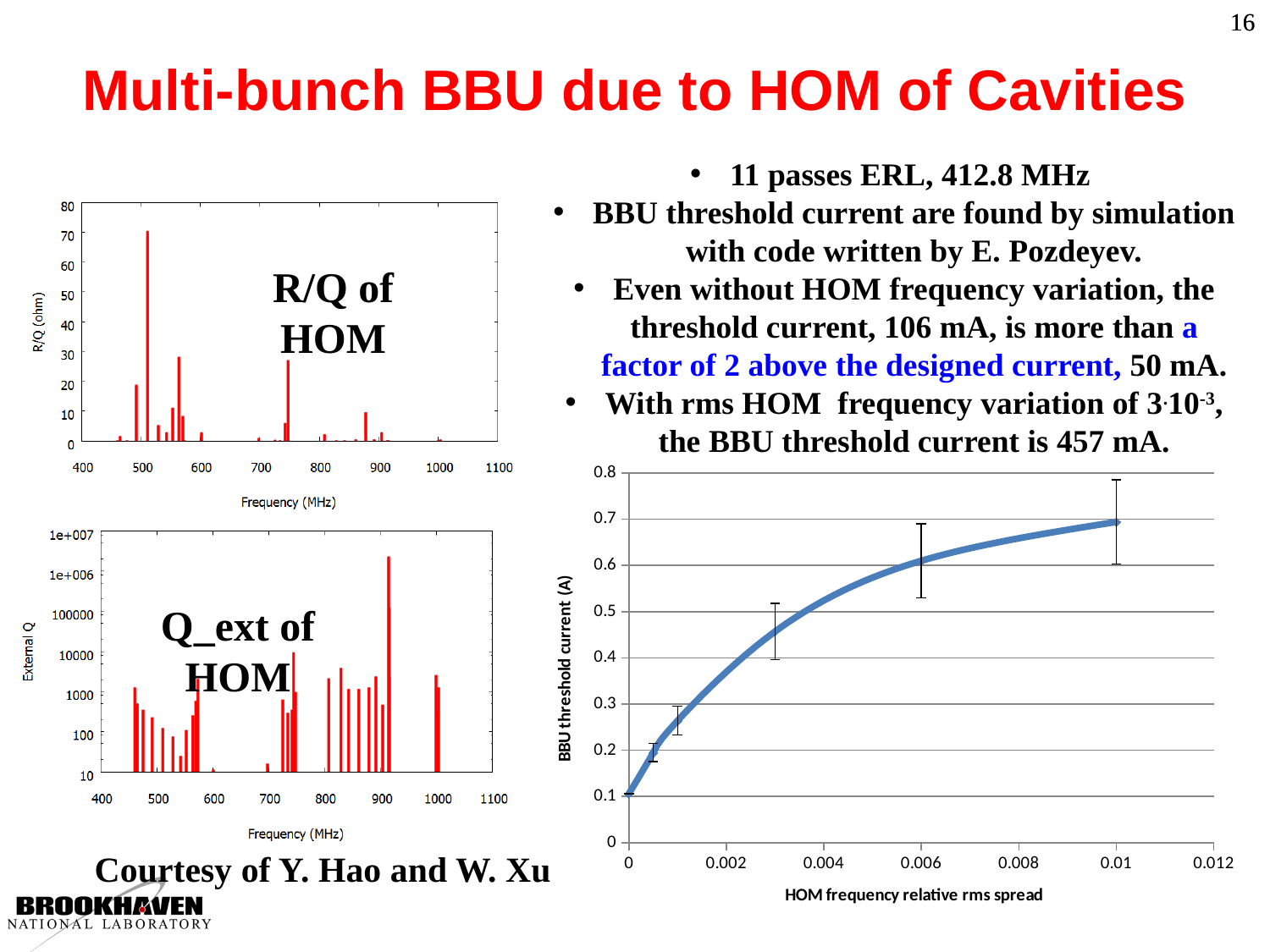
On the R/Q of HOM chart, is the peak near 750 MHz greater or less than 40 ohm? less On the chart of BBU threshold current versus HOM frequency relative rms spread, what kind of chart is it? line chart On the chart of BBU threshold current versus HOM frequency relative rms spread, is the value at an rms spread of 0.001 greater or less than 0.4? less On the chart of BBU threshold current versus HOM frequency relative rms spread, is the value at an rms spread of 0.003 greater or less than 0.4? greater On the chart of BBU threshold current versus HOM frequency relative rms spread, which is larger: the value at an rms spread of 0.01 or at 0.003? 0.01 On the Q_ext of HOM chart, what is the label of the horizontal axis? Frequency (MHz) On the chart of BBU threshold current versus HOM frequency relative rms spread, what is the label of the vertical axis? BBU threshold current (A) On the chart of BBU threshold current versus HOM frequency relative rms spread, does the threshold current rise or fall as the rms spread increases? rise